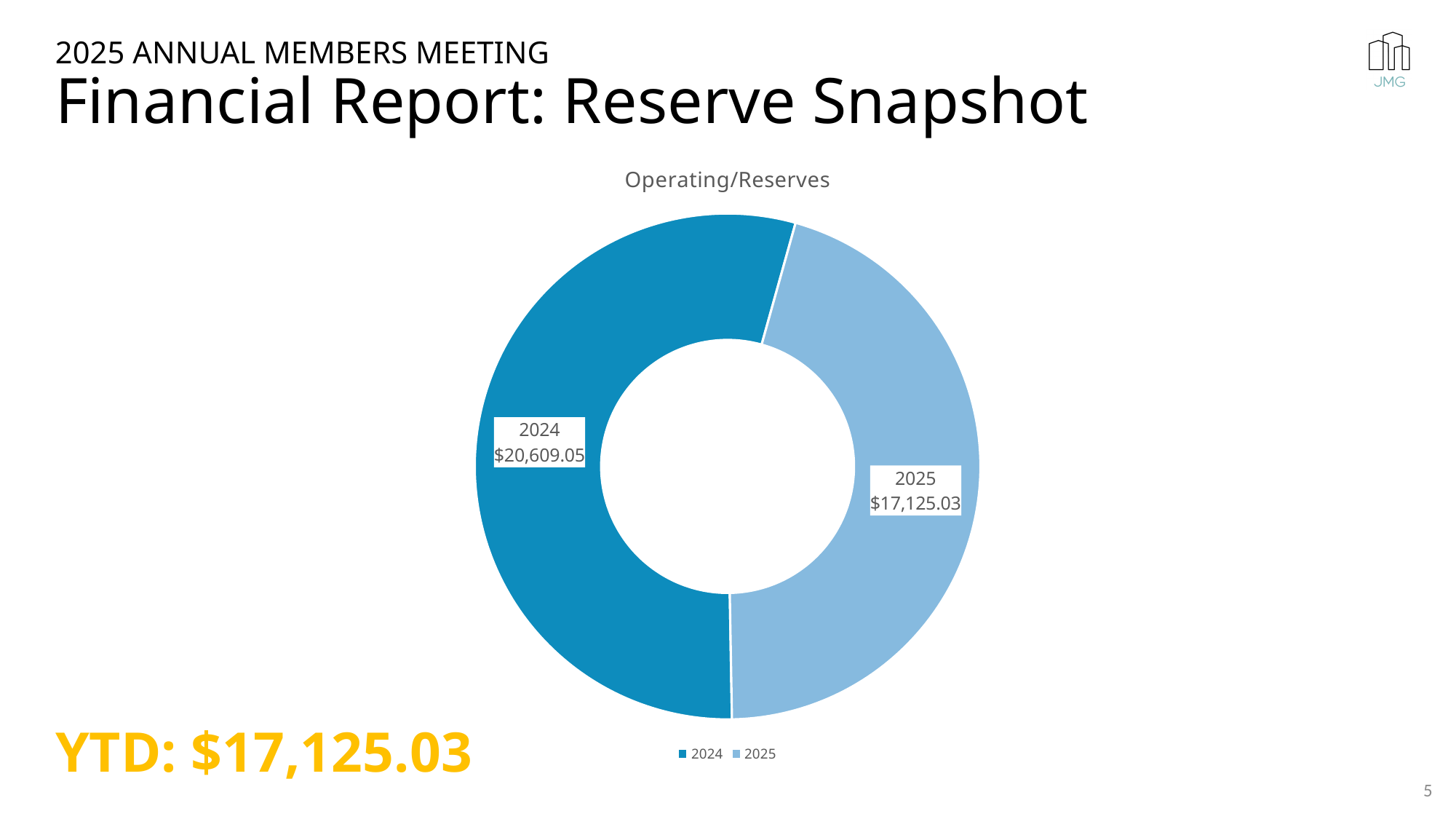
How many entries does the legend of the Operating/Reserves chart list? 2 What is the difference between the 2024 and 2025 values in the Operating/Reserves chart? $3,484.02 What is the combined total of the 2024 and 2025 values in the Operating/Reserves chart? $37,734.08 What is the value shown for 2024 in the Operating/Reserves chart? $20,609.05 What share of the Operating/Reserves chart does the 2024 slice represent, to one decimal place? 54.6% Is the 2025 value larger or smaller than the 2024 value in the Operating/Reserves chart? smaller Which year has the smaller slice in the Operating/Reserves chart? 2025 What kind of chart is shown on the slide? doughnut chart What is the value shown for 2025 in the Operating/Reserves chart? $17,125.03 Which year has the larger slice in the Operating/Reserves chart? 2024 How many slices does the Operating/Reserves chart have? 2 What is the title of the chart on the slide? Operating/Reserves